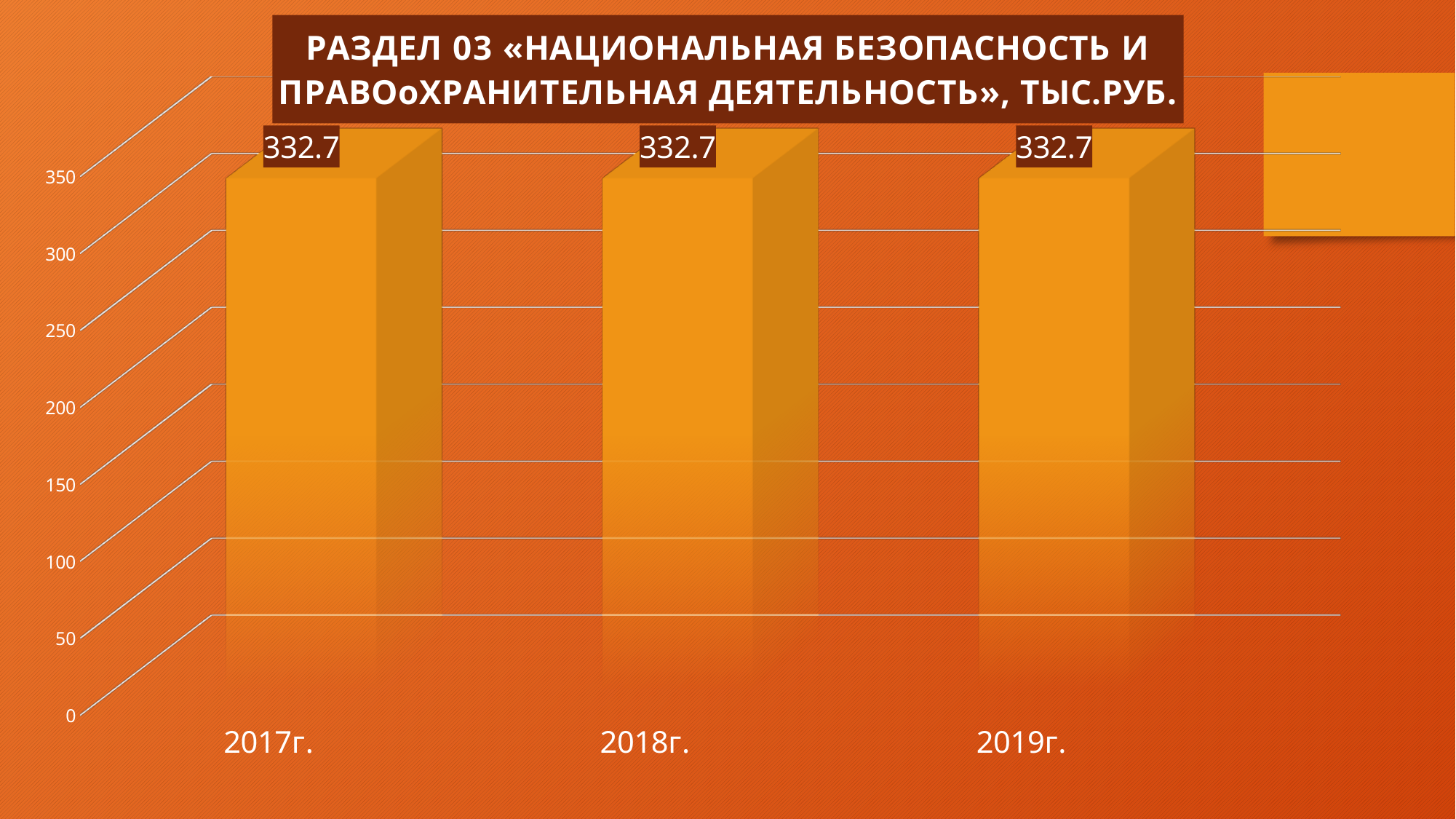
In what units are the values given, according to the chart title? тыс.руб. What is the value for 2018г.? 332.7 How many categories (years) are shown on the x axis? 3 What is the highest value shown on the vertical axis? 350 What kind of chart is shown on the slide? Bar chart Is the value for 2018г. larger than, smaller than, or equal to the value for 2017г.? Equal What is the difference between the values for 2019г. and 2017г.? 0 What is the value for 2019г.? 332.7 Is the value for 2019г. greater or less than 300? greater What is the value for 2017г.? 332.7 Do the values rise, fall, or stay the same from 2017г. to 2019г.? Stay the same